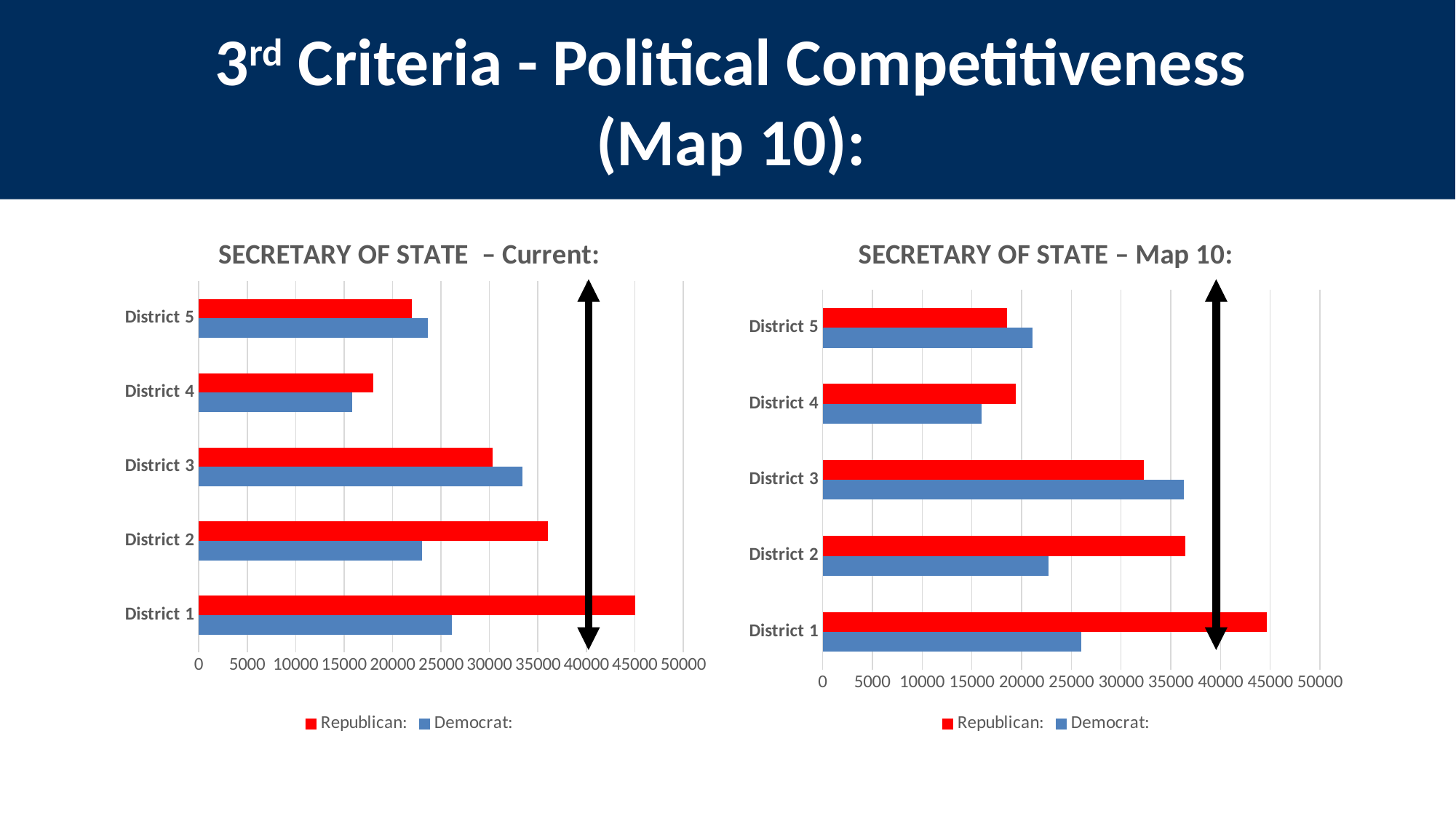
In the 'SECRETARY OF STATE – Current:' chart, which district has the highest Republican value? District 1 In the 'SECRETARY OF STATE – Current:' chart, is the Republican value for District 1 greater or less than 40000? greater What kind of chart is the 'SECRETARY OF STATE – Current:' chart? bar chart In the 'SECRETARY OF STATE – Map 10:' chart, which district has the lowest Democrat value? District 4 How many districts are shown on the 'SECRETARY OF STATE – Current:' chart? 5 How many series does the legend of the 'SECRETARY OF STATE – Map 10:' chart list? 2 In the 'SECRETARY OF STATE – Map 10:' chart, which is larger for District 3, the Republican or the Democrat value? Democrat In the 'SECRETARY OF STATE – Map 10:' chart, what colour represents the Republican series? red In the 'SECRETARY OF STATE – Map 10:' chart, is the Democrat value for District 4 greater or less than 20000? less In the 'SECRETARY OF STATE – Current:' chart, which district has the lowest Republican value? District 4 In the 'SECRETARY OF STATE – Current:' chart, which is larger for District 2, the Republican or the Democrat value? Republican In the 'SECRETARY OF STATE – Map 10:' chart, which district has the highest Democrat value? District 3